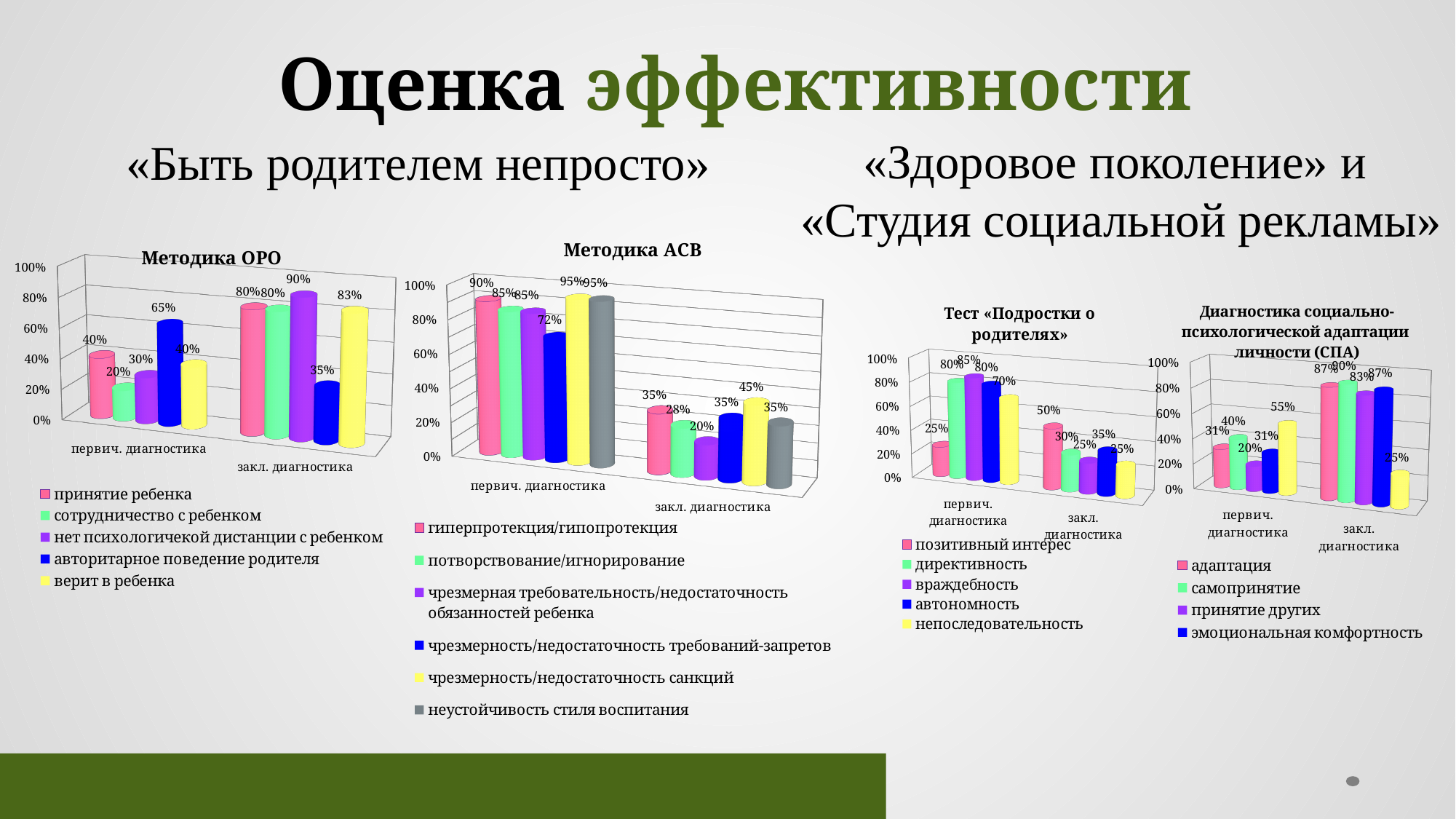
In the «Тест «Подростки о родителях»» chart, which is larger at «первич. диагностика»: «враждебность» or «непоследовательность»? враждебность In the «Диагностика социально-психологической адаптации личности (СПА)» chart, what is the difference between the «принятие других» values at «закл. диагностика» and «первич. диагностика»? 63% In the «Методика ОРО» chart, which series has the highest value at «закл. диагностика»? нет психологичекой дистанции с ребенком What kind of chart is the «Методика ОРО» chart? bar chart In the «Методика ОРО» chart, what is the difference between the «принятие ребенка» values at «закл. диагностика» and «первич. диагностика»? 40% In the «Методика АСВ» chart, does the value for «гиперпротекция/гипопротекция» rise or fall from «первич. диагностика» to «закл. диагностика»? fall How many series does the legend of the «Методика АСВ» chart list? 6 In the «Методика ОРО» chart, what is the value for «авторитарное поведение родителя» at «первич. диагностика»? 65% In the «Методика АСВ» chart, what is the value for «чрезмерность/недостаточность требований-запретов» at «первич. диагностика»? 72% In the «Методика АСВ» chart, which series has the lowest value at «закл. диагностика»? чрезмерная требовательность/недостаточность обязанностей ребенка In the «Тест «Подростки о родителях»» chart, what is the value for «позитивный интерес» at «закл. диагностика»? 50% In the «Диагностика социально-психологической адаптации личности (СПА)» chart, what is the value for «самопринятие» at «закл. диагностика»? 90%